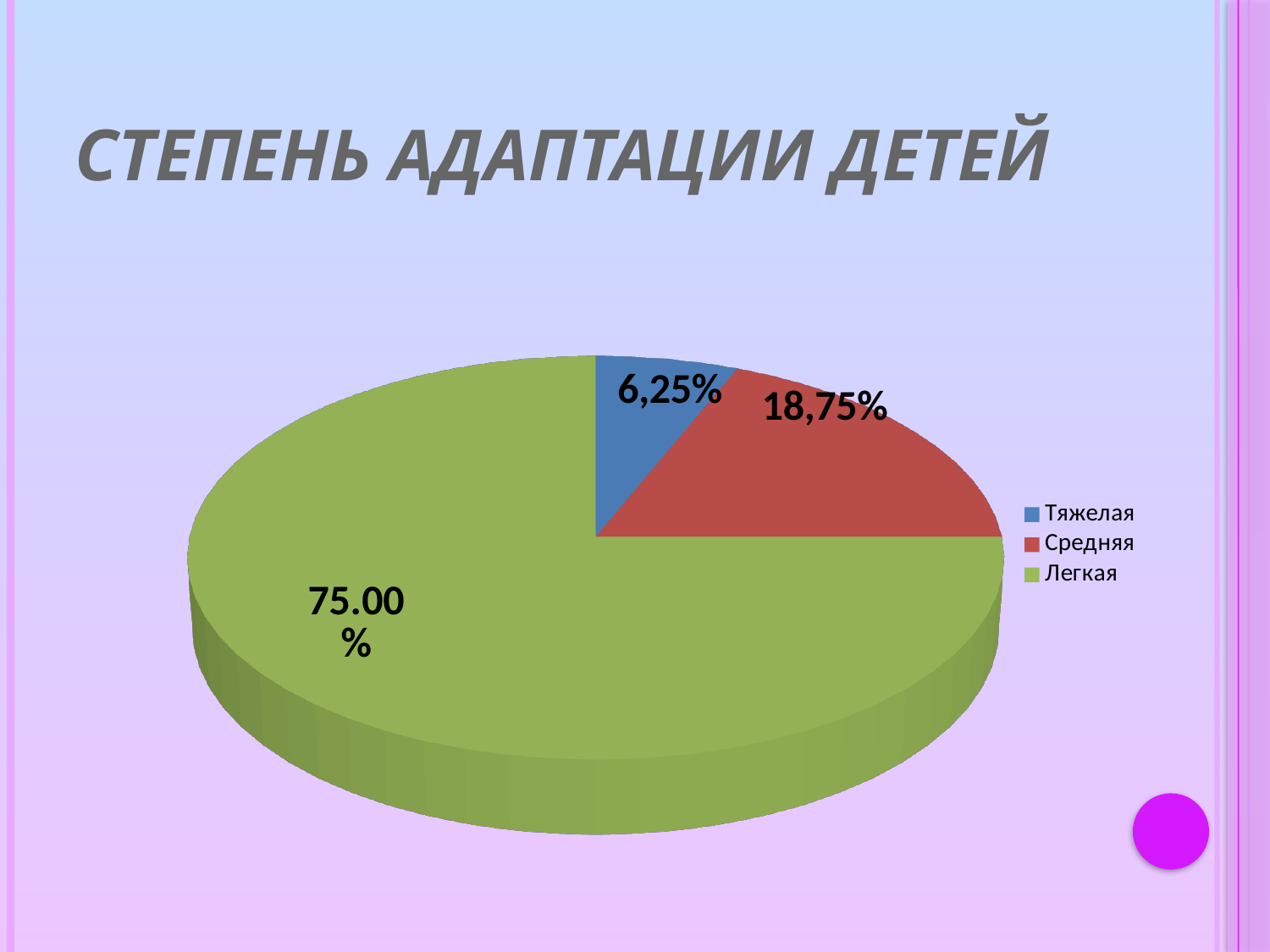
Which category has the largest slice of the pie? Легкая Which is larger, the slice for Средняя or the slice for Тяжелая? Средняя Which category has the smallest slice of the pie? Тяжелая What is the value shown for Легкая? 75.00% What is the difference between the values for Средняя and Тяжелая? 12,5% What kind of chart is shown on the slide? pie chart What is the difference between the values for Легкая and Средняя? 56,25% What is the title of the chart on the slide? СТЕПЕНЬ АДАПТАЦИИ ДЕТЕЙ What is the value shown for Тяжелая? 6,25% What colour is the slice for Средняя? red How many categories does the pie chart have? 3 What is the value shown for Средняя? 18,75%